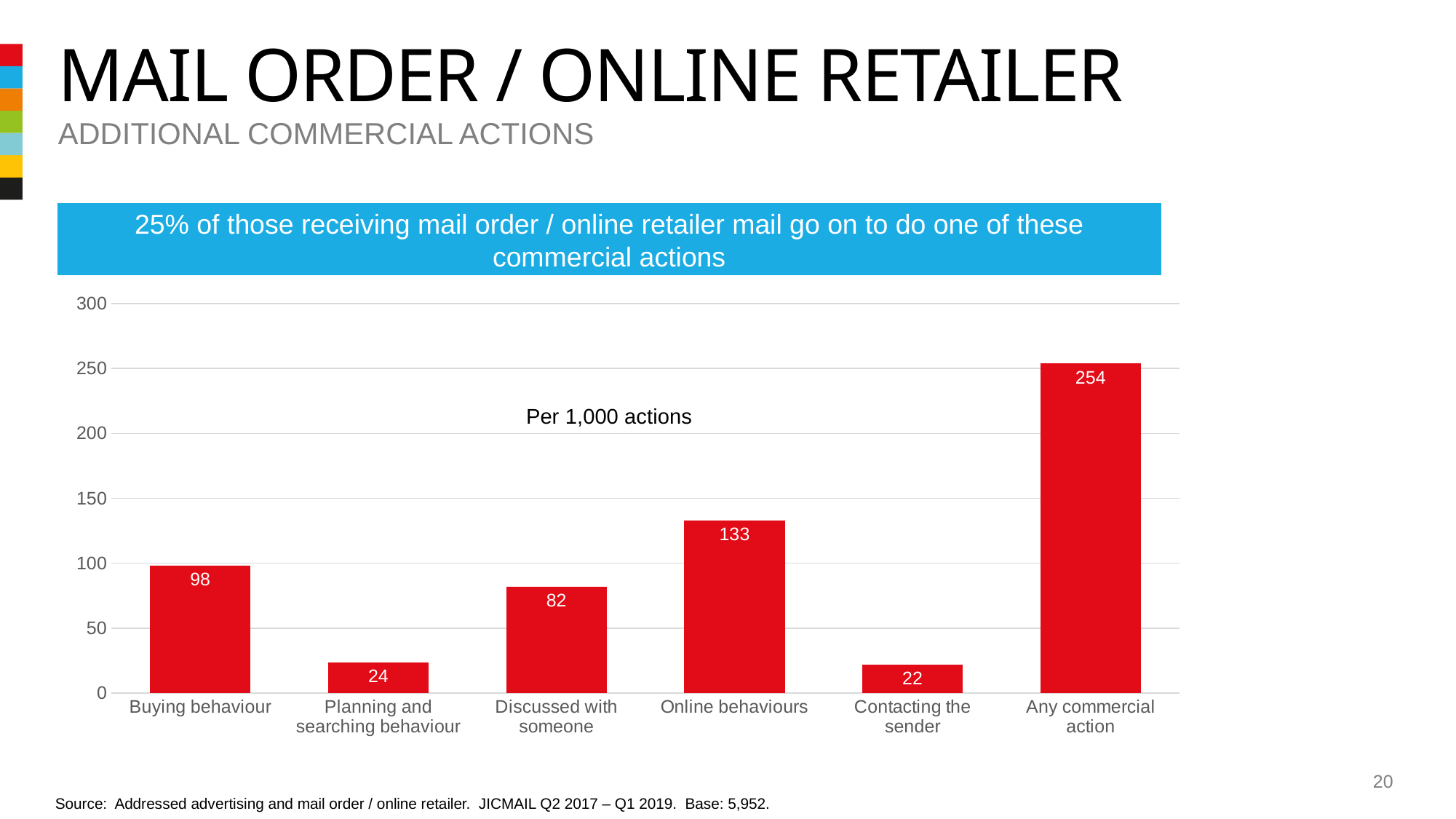
Which is larger, Buying behaviour or Discussed with someone? Buying behaviour Is the value for Any commercial action greater or less than 200? greater What is the difference between Online behaviours and Discussed with someone? 51 What unit label is printed inside the chart area? Per 1,000 actions What kind of chart is shown on the slide? Bar chart What is the value for Contacting the sender? 22 What is the value for Online behaviours? 133 What is the value for Buying behaviour? 98 What is the value for Any commercial action? 254 Which category has the highest value? Any commercial action Which category has the lowest value? Contacting the sender How many categories are shown on the x axis? 6